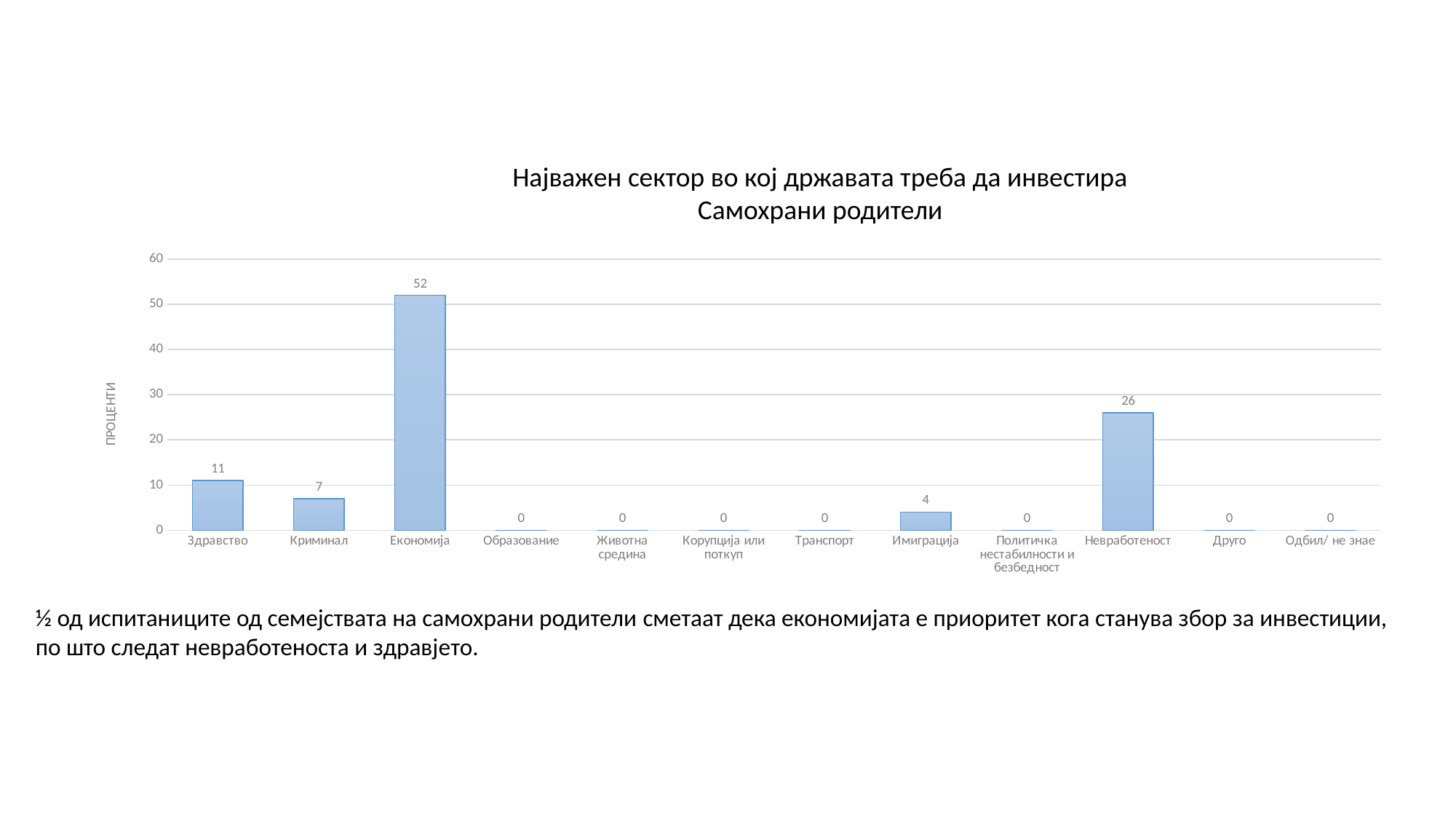
Which category has the highest value? Економија What is the difference between the values for Економија and Невработеност? 26 Is the value for Економија greater or less than 50? greater How many categories are shown on the x axis? 12 What is the label of the vertical axis? ПРОЦЕНТИ What is the value for Невработеност? 26 What is the value for Имиграција? 4 What is the value for Здравство? 11 What is the difference between the values for Здравство and Криминал? 4 What is the value for Економија? 52 What kind of chart is shown on the slide? bar chart Which is larger, the value for Здравство or the value for Криминал? Здравство